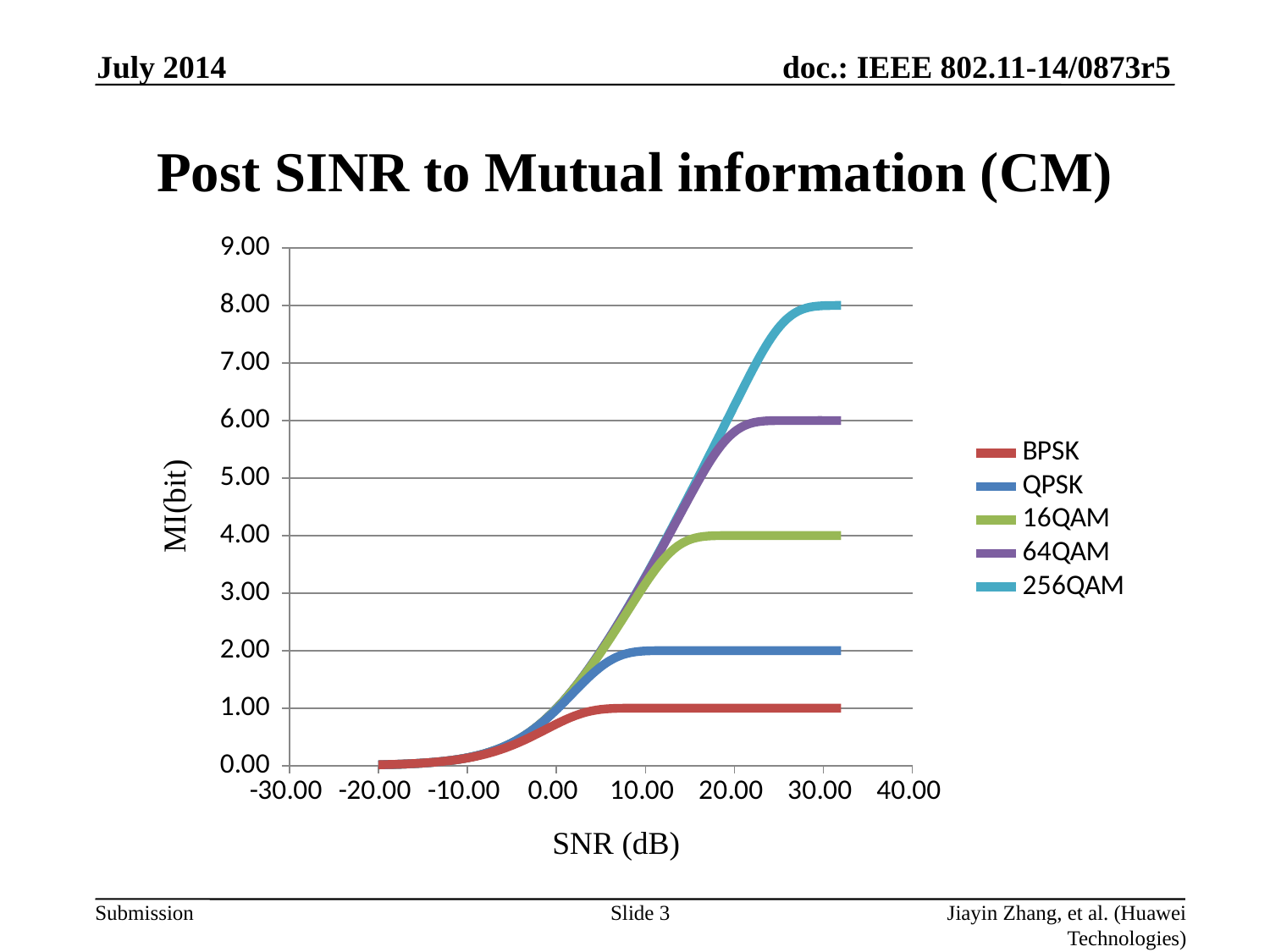
Which series has the lowest MI value at high SNR? BPSK Which series reaches the highest MI value at high SNR? 256QAM Do the MI values rise or fall as SNR increases along the x axis? rise At what MI value does the BPSK curve level off? 1.00 At what MI value does the 64QAM curve level off? 6.00 What kind of chart is shown on the slide? line chart What is the label of the x axis? SNR (dB) Is the MI value for 256QAM at 30.00 dB SNR greater or less than 7.00? greater At 30.00 dB SNR, which series has the larger MI value, QPSK or 64QAM? 64QAM Is the MI value for 16QAM at 30.00 dB SNR greater or less than 5.00? less How many series does the legend list? 5 What is the title of the chart? Post SINR to Mutual information (CM)